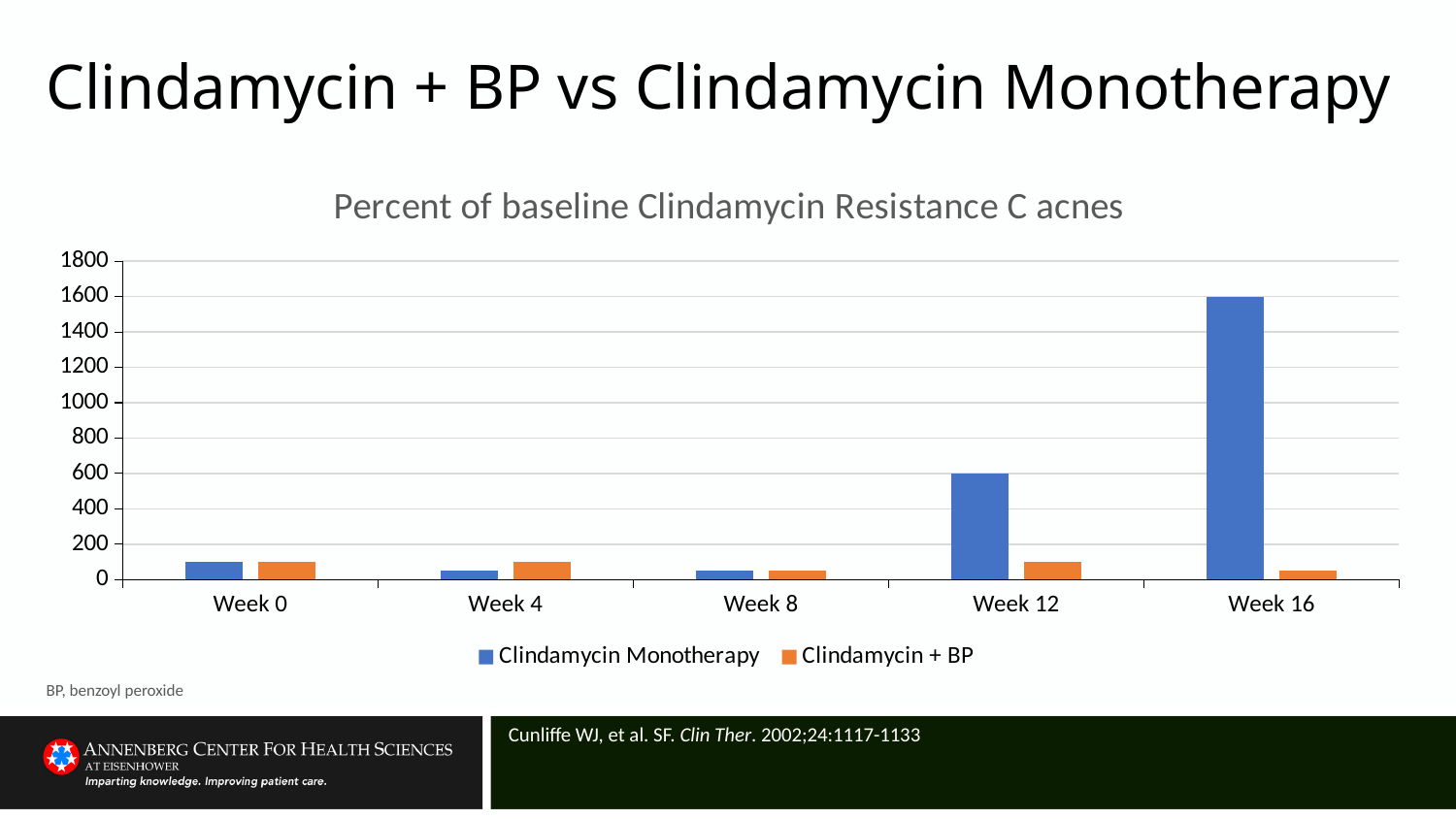
How many series does the legend list? 2 At Week 12, which series has the larger value, Clindamycin Monotherapy or Clindamycin + BP? Clindamycin Monotherapy What kind of chart is shown on the slide? Bar chart Does the Clindamycin Monotherapy value rise or fall from Week 8 to Week 16? Rise How many week categories are shown on the x axis? 5 What is the Clindamycin Monotherapy value at Week 16? 1600 Is the Clindamycin + BP value at Week 16 greater or less than 200? less Is the Clindamycin Monotherapy value at Week 16 greater or less than 1400? greater At which week is the Clindamycin Monotherapy value highest? Week 16 What is the Clindamycin Monotherapy value at Week 12? 600 What is the title of the chart? Percent of baseline Clindamycin Resistance C acnes Which series is shown in orange in the legend? Clindamycin + BP